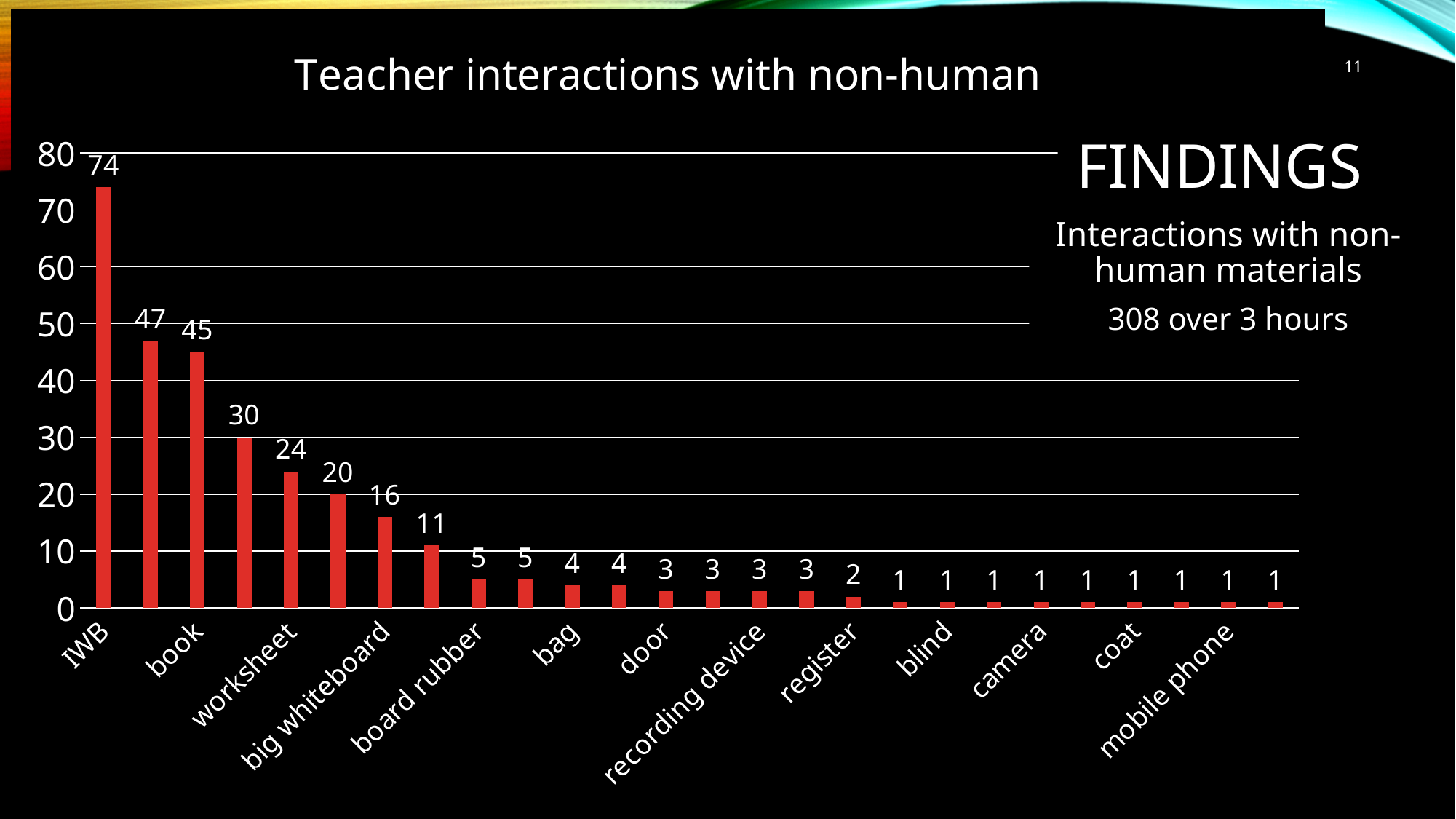
Do the values rise or fall from left to right along the x axis? fall What is the difference between the values for IWB and book? 29 Which is larger, the value for worksheet or the value for big whiteboard? worksheet What is the value for big whiteboard? 16 What kind of chart is shown on the slide? bar chart Which category has the highest value? IWB What is the value for IWB? 74 What is the value for register? 2 What is the value for worksheet? 24 How many bars are plotted in the chart? 26 What is the title of the chart? Teacher interactions with non-human What is the value for book? 45